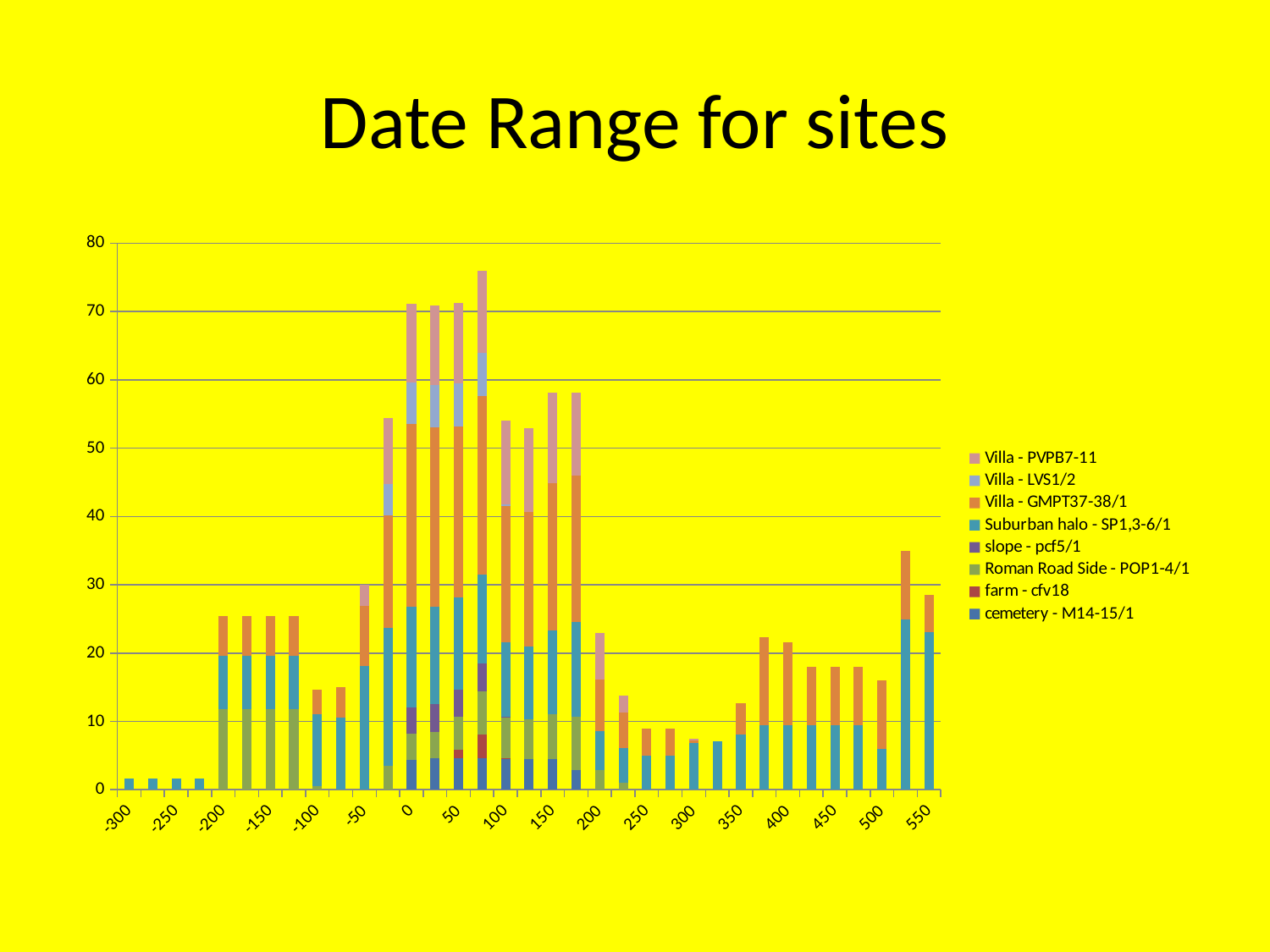
How many series does the legend list? 8 Is the total value of the bar at 550 greater or less than 20? greater Which bar is taller, the one at 0 or the one at 550? 0 Is the total value of the bar at -300 greater or less than 10? less What is the title of the chart? Date Range for sites Which series is listed last (at the bottom) in the legend? cemetery - M14-15/1 Is the total value of the bar at 0 greater or less than 60? greater What kind of chart is shown on the slide? stacked bar chart Do the bar totals rise or fall from 200 to 300 on the x axis? fall